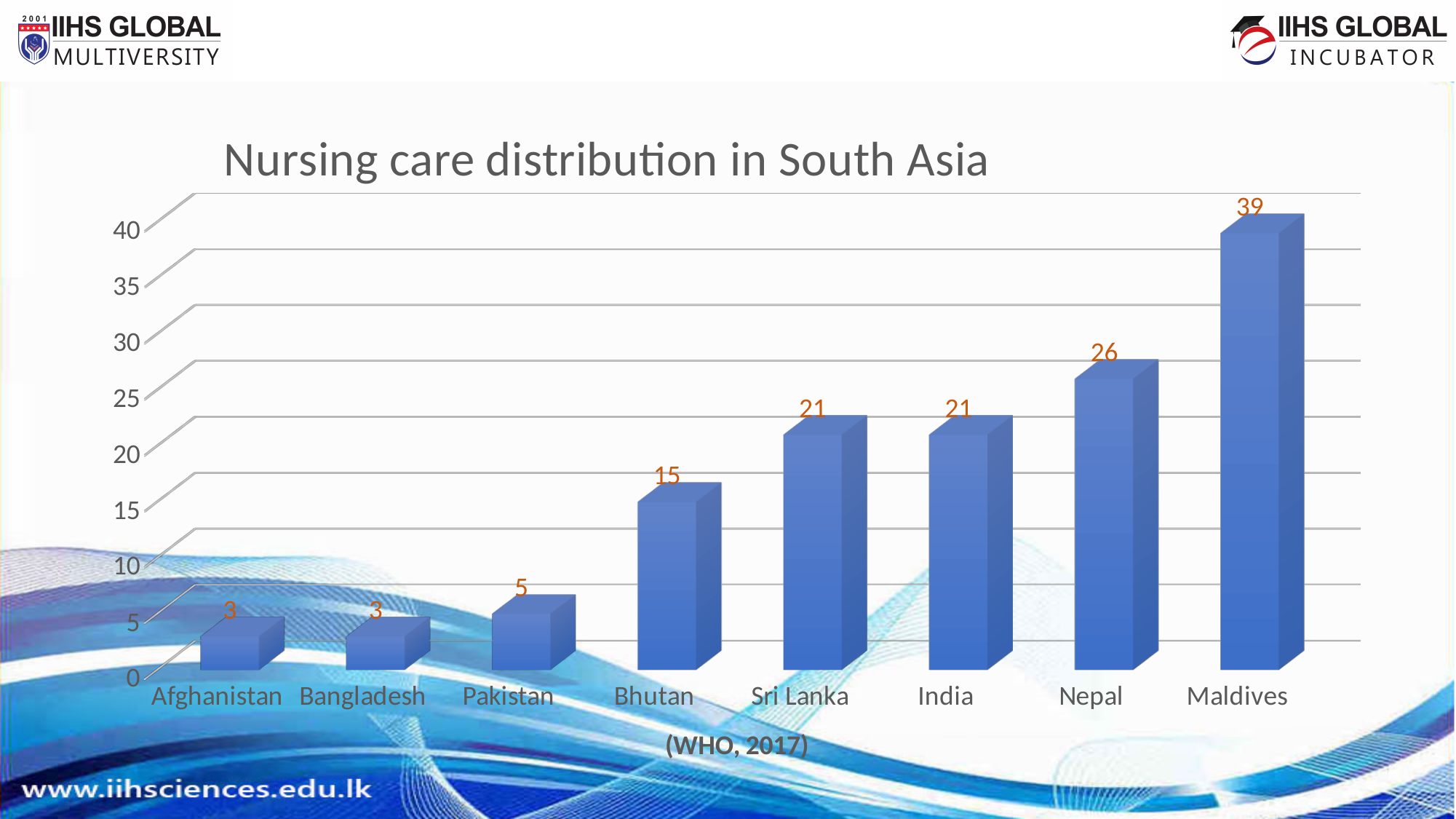
Is the value for Nepal greater or less than 25? greater What is the value for Bhutan? 15 What is the value for Nepal? 26 What kind of chart is shown? bar chart What is the title of the chart? Nursing care distribution in South Asia Do the values generally rise or fall from Afghanistan to Maldives? rise What is the value for Maldives? 39 Which country has the lowest value, Pakistan or Bhutan? Pakistan What is the difference between the values for Bhutan and Pakistan? 10 Which country has the highest value? Maldives How many countries are shown on the chart? 8 What is the difference between the values for Maldives and Nepal? 13